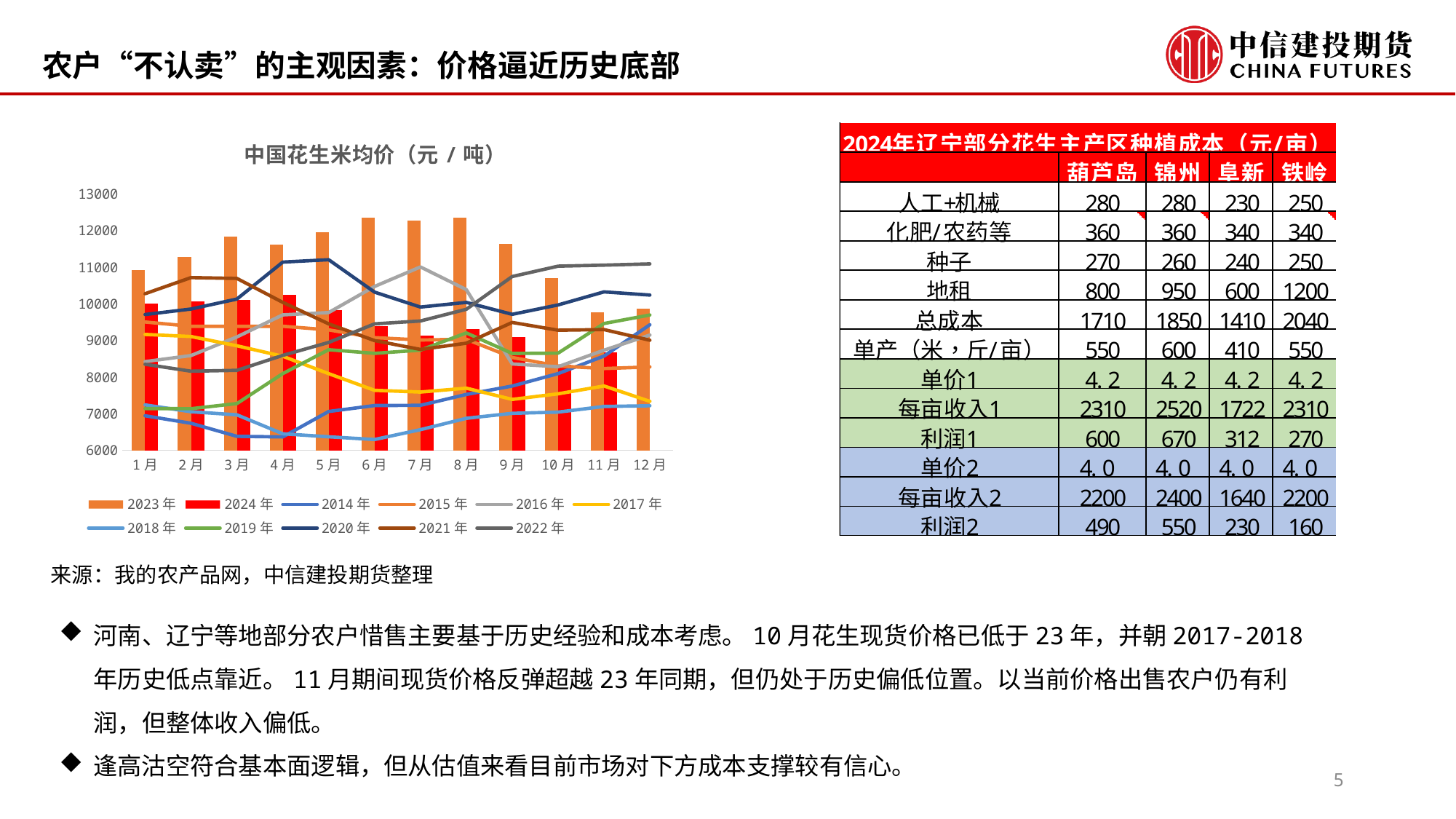
In 1月, which is larger: the 2023年 value or the 2024年 value? 2023年 How many series does the chart's legend list? 11 Which two series are drawn as bars in the chart? 2023年 and 2024年 Is the 2024年 value for 11月 greater or less than 9000? less Do the 2023年 bars rise or fall from 8月 to 11月? fall Is the 2023年 value for 6月 greater or less than 12000? greater Is the 2022年 value for 12月 greater or less than 10000? greater What is the title of the chart on the slide? 中国花生米均价（元／吨） What kind of chart is shown on the slide? A bar chart combined with line series How many months are shown on the x axis of the chart? 12